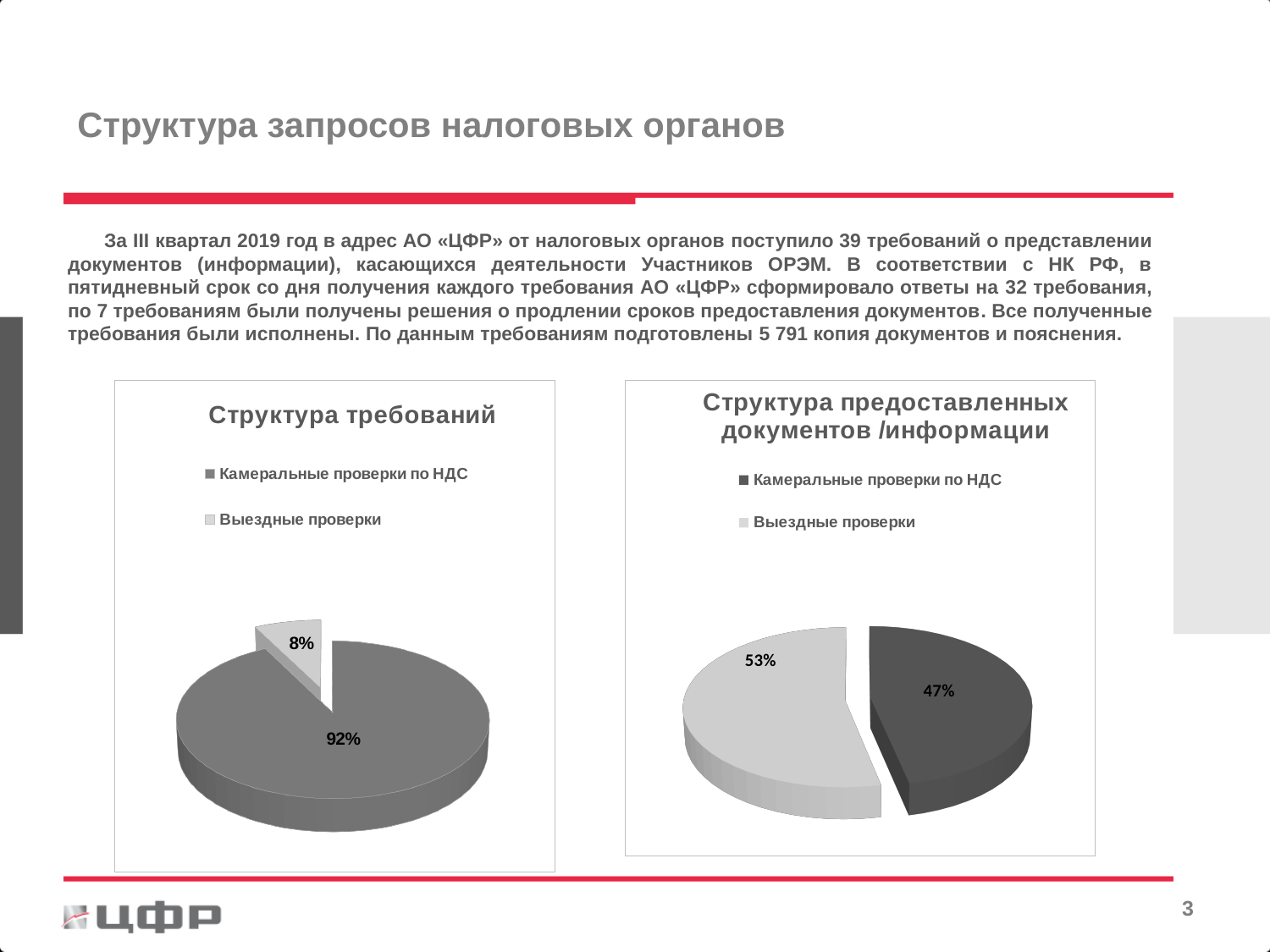
In the chart titled "Структура требований", what share is shown for Выездные проверки? 8% In the chart titled "Структура требований", what share is shown for Камеральные проверки по НДС? 92% In the chart titled "Структура предоставленных документов /информации", what share is shown for Камеральные проверки по НДС? 47% How many charts are shown on the slide? 2 In the chart titled "Структура предоставленных документов /информации", which is larger: Выездные проверки or Камеральные проверки по НДС? Выездные проверки In the chart titled "Структура предоставленных документов /информации", which category has the smallest slice? Камеральные проверки по НДС What type of chart is the left chart titled "Структура требований"? Pie chart In the chart titled "Структура требований", which category has the largest slice? Камеральные проверки по НДС In the chart titled "Структура требований", what is the difference in percentage points between Камеральные проверки по НДС and Выездные проверки? 84 What is the title of the right chart on the slide? Структура предоставленных документов /информации In the chart titled "Структура предоставленных документов /информации", what share is shown for Выездные проверки? 53% How many categories does the legend of the chart titled "Структура предоставленных документов /информации" list? 2